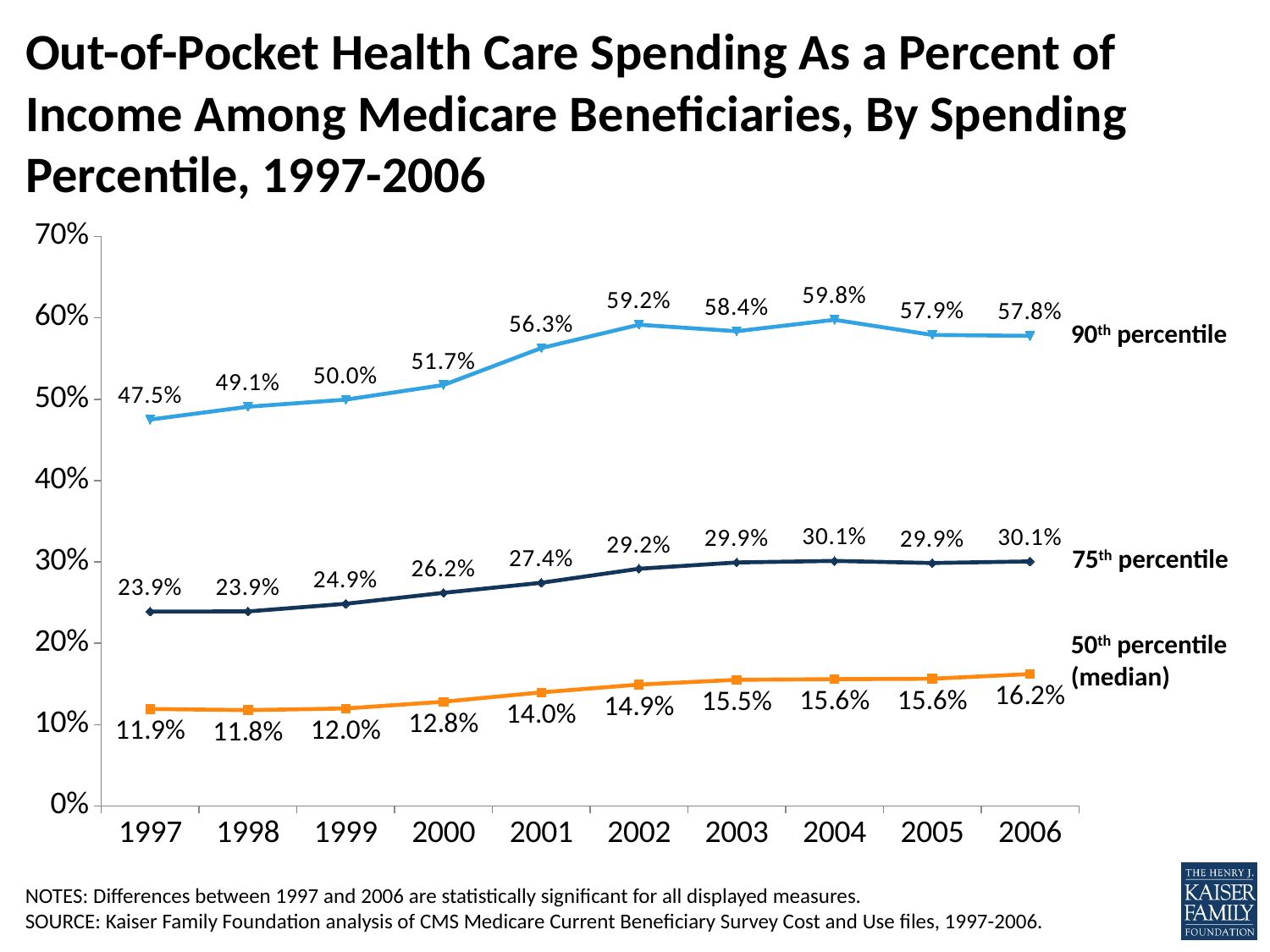
Is the 90th percentile value in 2001 greater or less than 50%? greater How many series (percentile lines) are plotted on the chart? 3 How many years are shown on the x axis? 10 Which is larger: the 75th percentile value in 2002 or in 2000? 2002 What was the value for the 75th percentile in 2001? 27.4% What was the value for the 50th percentile (median) in 1997? 11.9% What kind of chart is shown on the slide? Line chart Did the 75th percentile value generally rise or fall from 1997 to 2006? Rise In which year was the 90th percentile value highest? 2004 In which year was the 50th percentile (median) value lowest? 1998 What is the difference between the 90th percentile values in 2006 and 1997? 10.3% What was the out-of-pocket spending as a percent of income for the 90th percentile in 2004? 59.8%